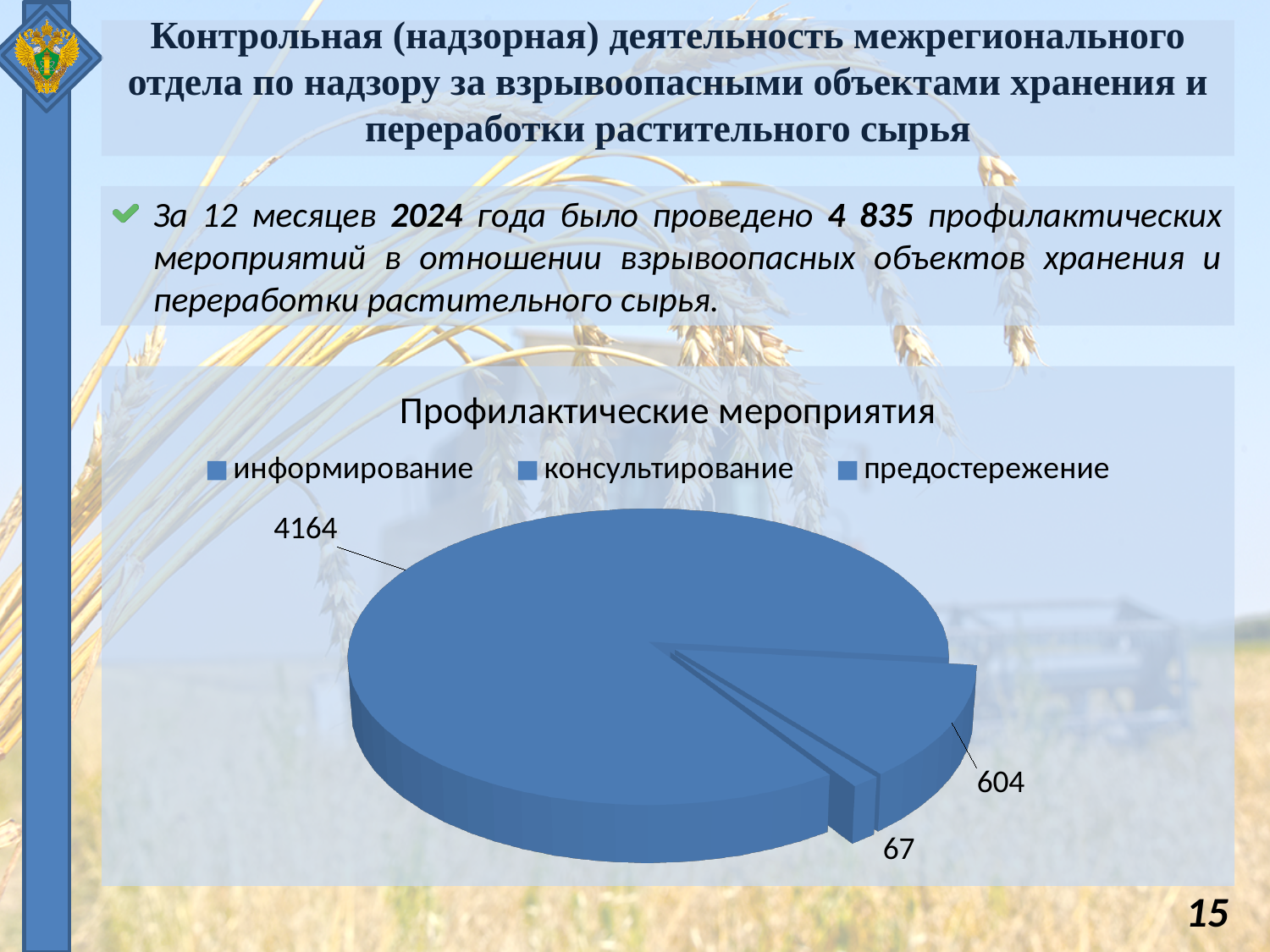
What kind of chart is shown on the slide? pie chart What is the difference between the largest labelled value (4164) and the value 604 on the pie chart? 3560 How many entries does the chart legend list? 3 What is the total of all the values labelled on the pie chart? 4835 Which is larger on the pie chart: the slice labelled 604 or the slice labelled 67? 604 What is the largest value labelled on the pie chart? 4164 What is the difference between the slices labelled 604 and 67? 537 What is the smallest value labelled on the pie chart? 67 What is the title of the chart? Профилактические мероприятия What are the three legend entries of the chart? информирование, консультирование, предостережение How many slices does the pie chart have? 3 What share of the whole pie does the slice labelled 4164 represent? 86%